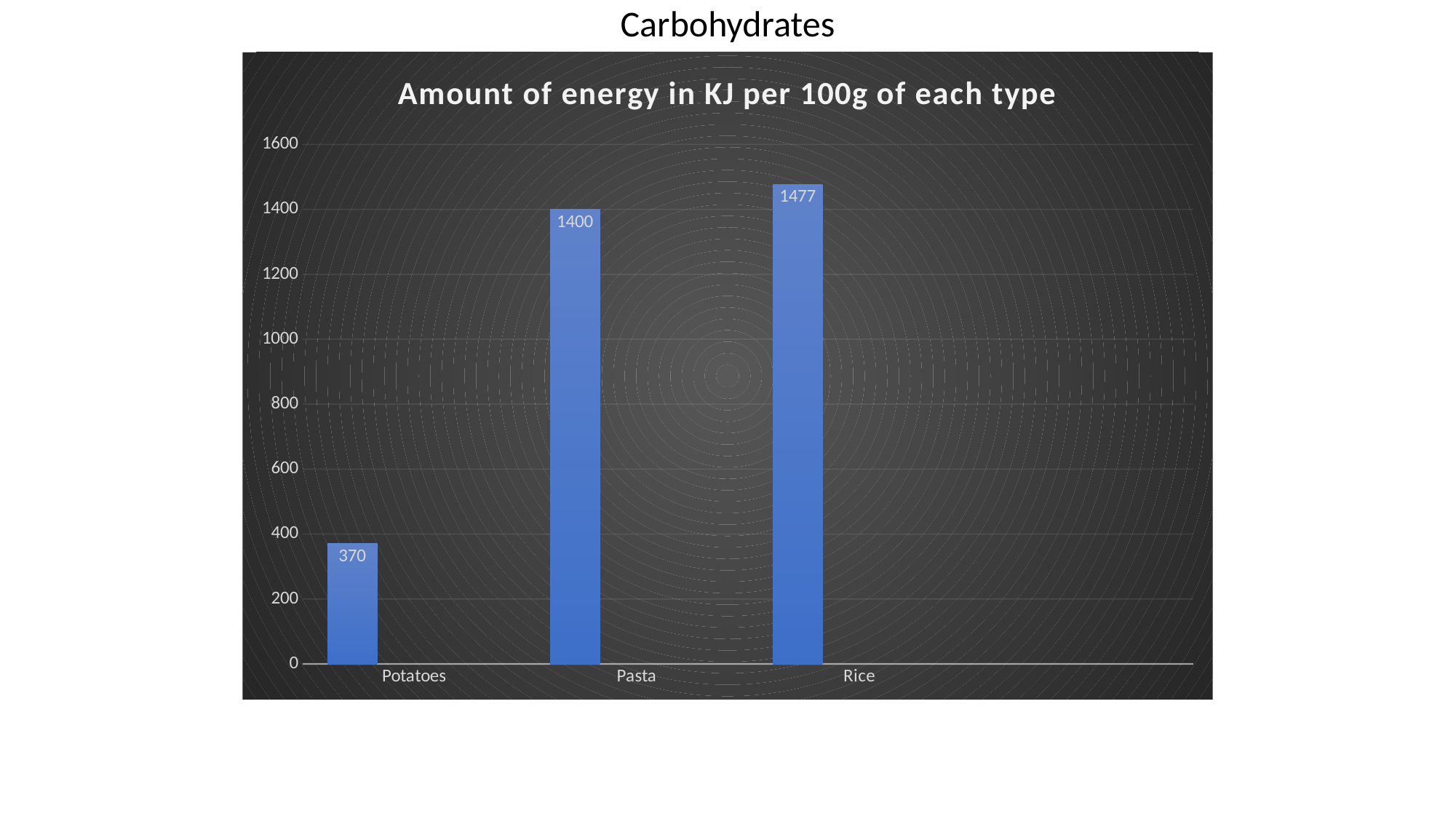
What is the value for Pasta? 1400 What is the difference between the values for Rice and Pasta? 77 Which is larger, the value for Potatoes or the value for Pasta? Pasta Is the value for Potatoes greater or less than 400? less What kind of chart is shown on the slide? bar chart Which category has the highest value? Rice Which category has the lowest value? Potatoes What is the title of the chart? Amount of energy in KJ per 100g of each type How many categories are shown on the x axis? 3 What is the value for Potatoes? 370 What is the difference between the values for Pasta and Potatoes? 1030 What is the value for Rice? 1477